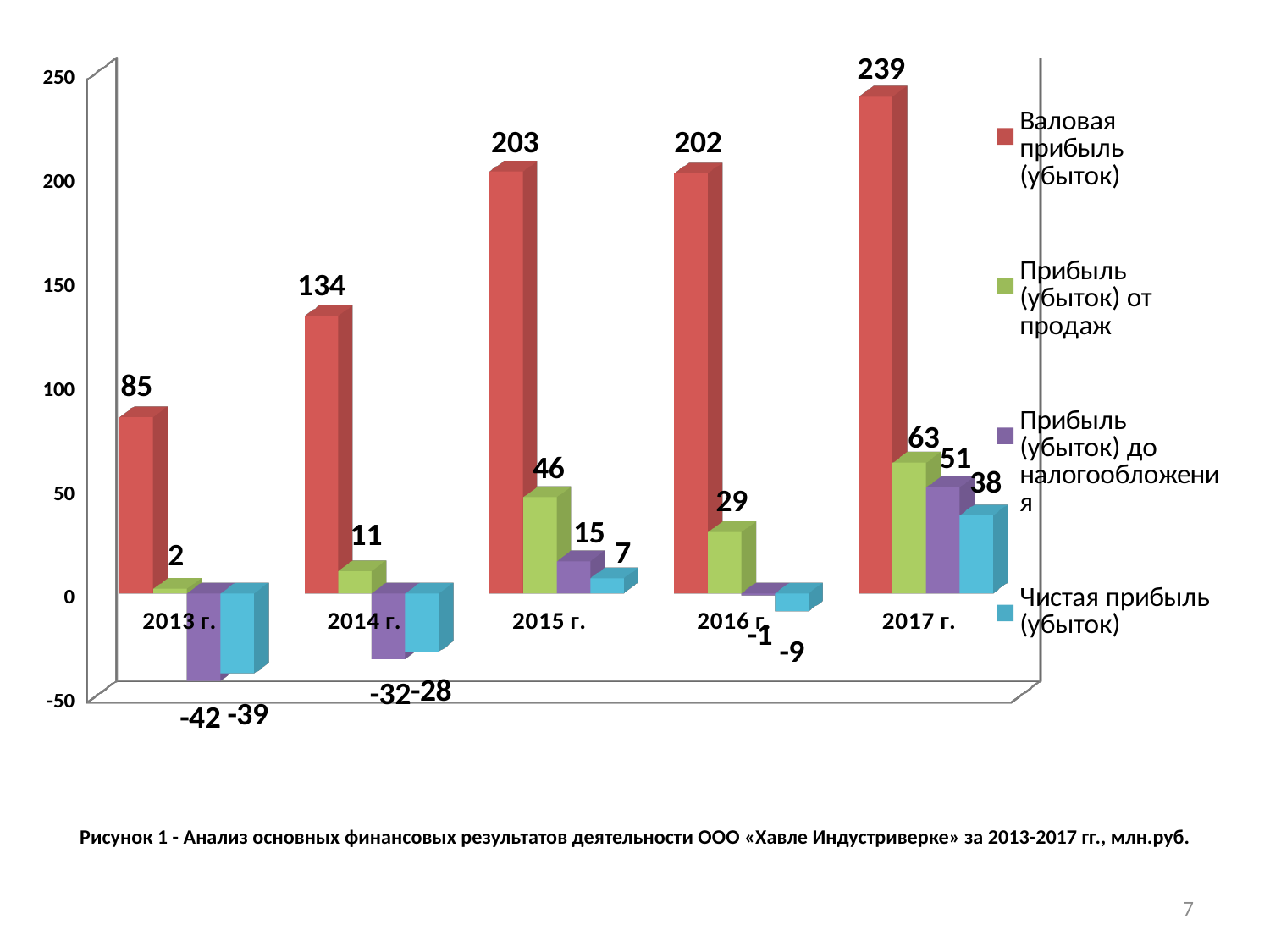
What is the value of Прибыль (убыток) от продаж for 2015 г.? 46 What is the value of Прибыль (убыток) до налогообложения for 2016 г.? -1 Which is larger: Прибыль (убыток) от продаж in 2016 г. or in 2017 г.? 2017 г. What is the value of Валовая прибыль (убыток) for 2017 г.? 239 Does Чистая прибыль (убыток) rise or fall from 2016 г. to 2017 г.? Rise How many series does the legend list? 4 How many years are shown on the x axis? 5 What kind of chart is shown on the slide? Bar chart In which year is Валовая прибыль (убыток) the highest? 2017 г. What is the value of Чистая прибыль (убыток) for 2013 г.? -39 What is the difference between Валовая прибыль (убыток) in 2014 г. and in 2013 г.? 49 In which year is Прибыль (убыток) до налогообложения the lowest? 2013 г.